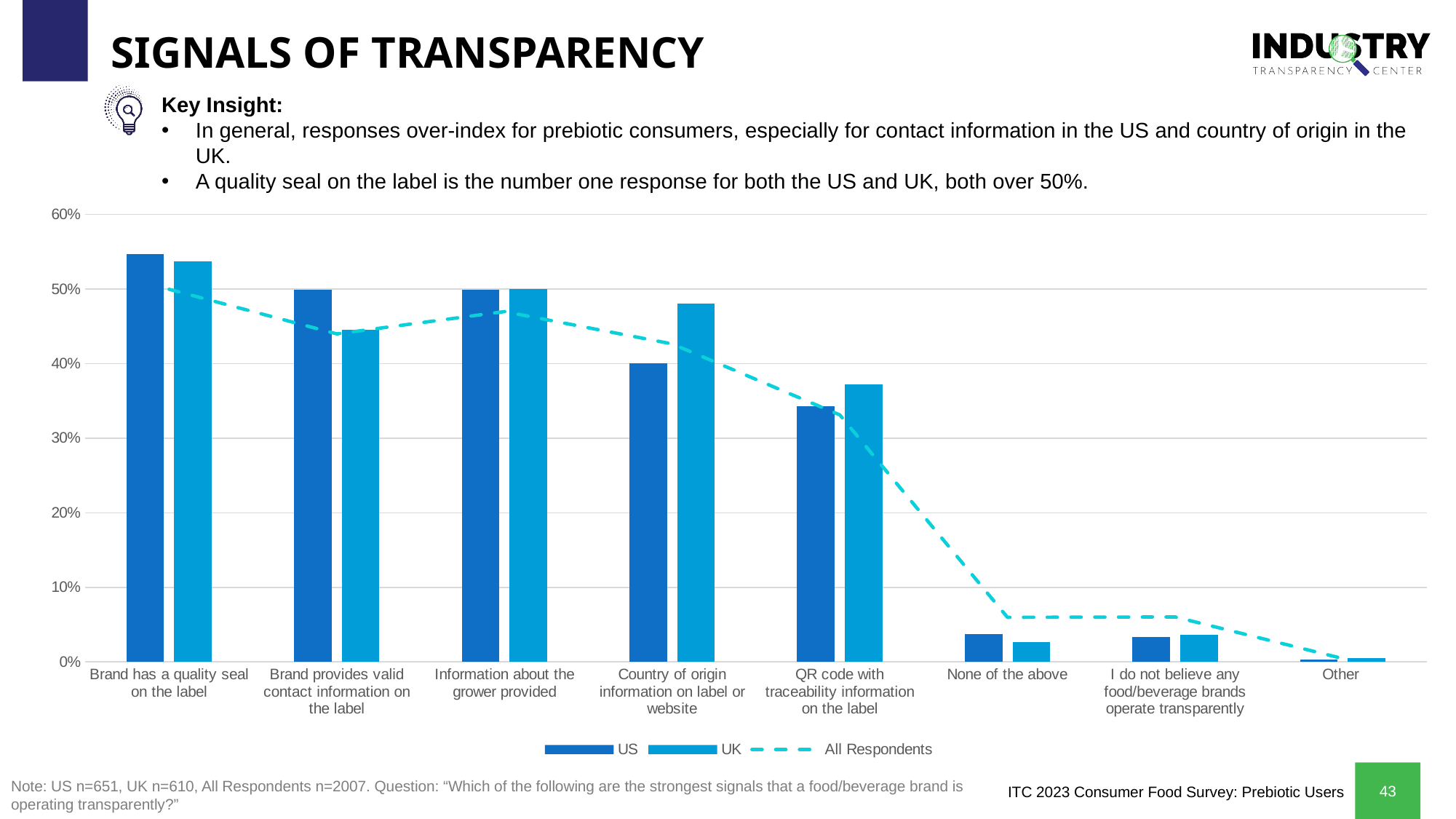
Is the US value for 'QR code with traceability information on the label' greater or less than 30%? greater What kind of chart is shown on the slide? combination bar and line chart How many series does the legend list? 3 How many categories are shown on the x axis? 8 Which category has the lowest UK value? Other Which category has the highest US value? Brand has a quality seal on the label For 'Brand provides valid contact information on the label', which is larger, the US value or the UK value? US Is the US value for 'Brand has a quality seal on the label' greater or less than 50%? greater Is the UK value for 'Brand provides valid contact information on the label' greater or less than 50%? less For 'Country of origin information on label or website', which is larger, the US value or the UK value? UK Does the All Respondents line generally rise or fall from left to right across the categories? fall